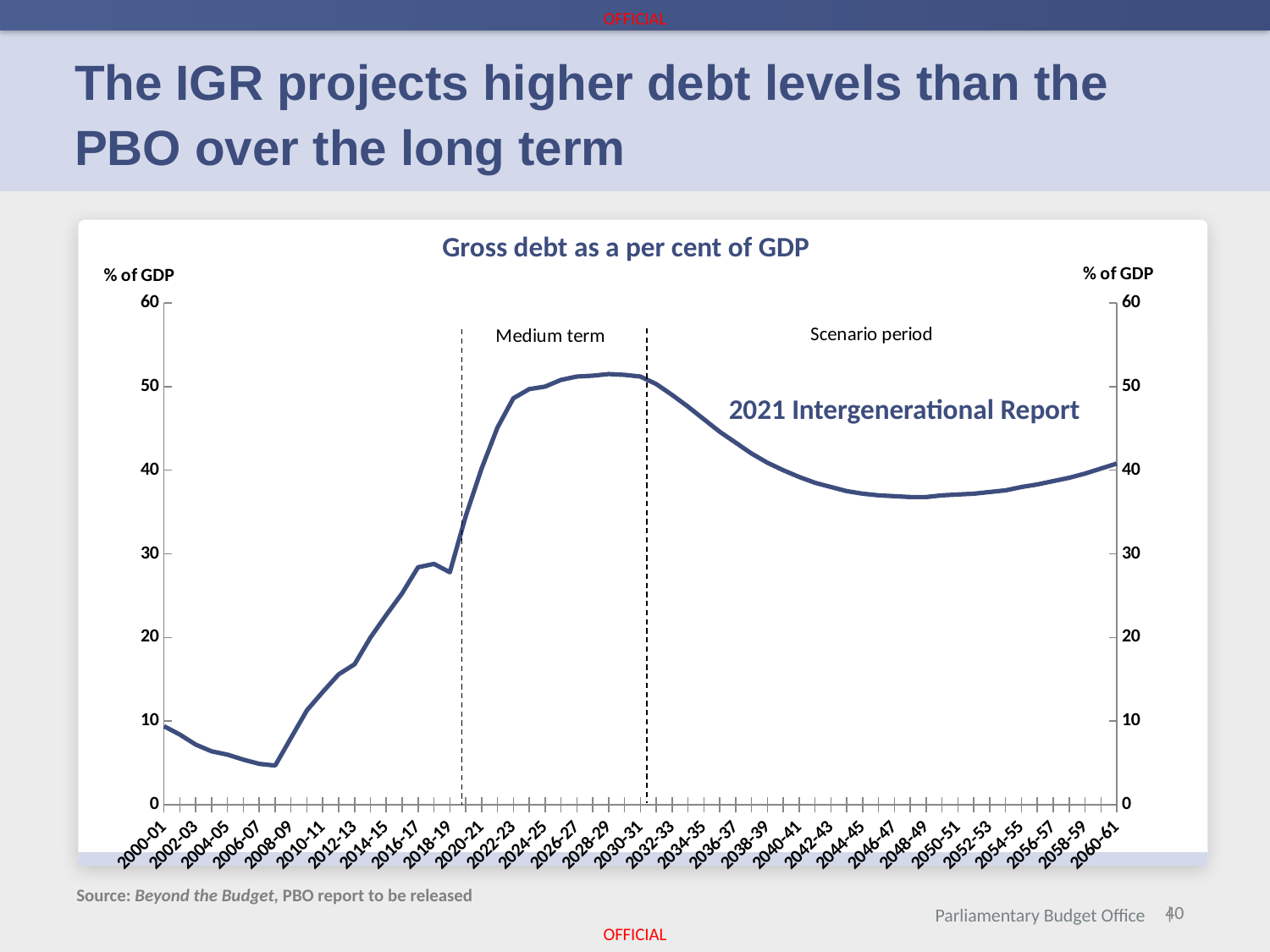
Is the value for 2060-61 greater or less than 30? greater What is the title of the chart? Gross debt as a per cent of GDP What series label is printed next to the line on the chart? 2021 Intergenerational Report Is the value for 2048-49 greater or less than 40? less Does the line rise or fall between 2008-09 and 2028-29? rise Is the value for 2008-09 greater or less than 10? less Which is larger, the value for 2028-29 or the value for 2060-61? 2028-29 What kind of chart is shown on the slide? line chart Does the line rise or fall between 2030-31 and 2048-49? fall